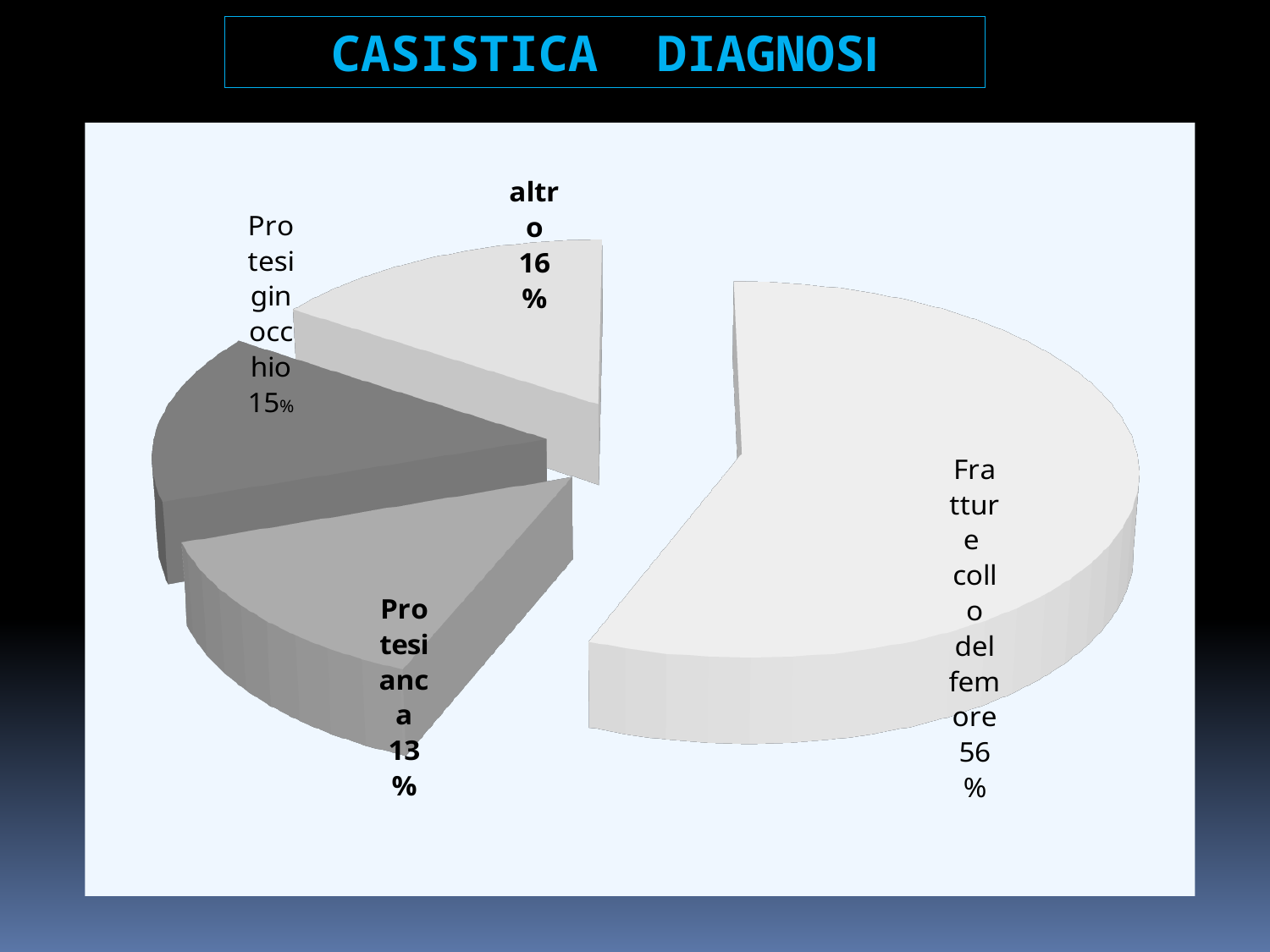
Which category has the largest share of the pie? Fratture collo del femore What is the difference in percentage points between Protesi ginocchio and Protesi anca? 2 Which is larger, the share for altro or the share for Protesi anca? altro What percentage is shown for Fratture collo del femore? 56% How many slices does the pie chart have? 4 What percentage is shown for Protesi ginocchio? 15% What is the difference in percentage points between Fratture collo del femore and altro? 40 What percentage is shown for Protesi anca? 13% What kind of chart is shown on the slide? pie chart What percentage is shown for altro? 16% Which category has the smallest share of the pie? Protesi anca What is the title of the slide? CASISTICA DIAGNOSI